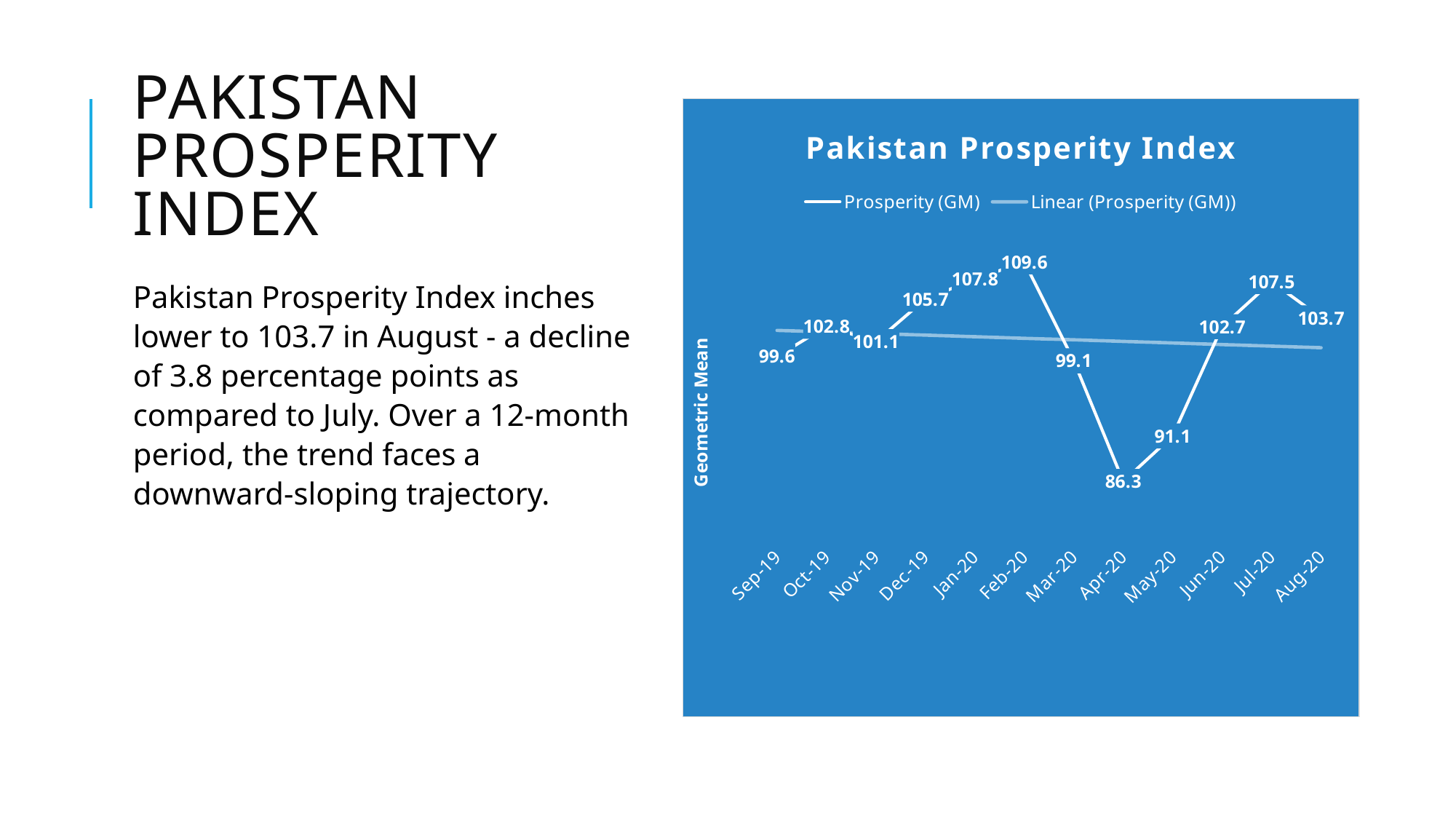
What is the Prosperity (GM) value for Sep-19? 99.6 Which month has the lowest Prosperity (GM) value? Apr-20 What is the label on the vertical axis of the chart? Geometric Mean What is the Prosperity (GM) value for Feb-20? 109.6 Which month has a larger Prosperity (GM) value, Mar-20 or May-20? Mar-20 How many series does the legend list? 2 What kind of chart is shown? Line chart Which month has the highest Prosperity (GM) value? Feb-20 How many months are plotted on the x axis? 12 What is the Prosperity (GM) value for Apr-20? 86.3 Does the Prosperity (GM) value rise or fall from Feb-20 to Apr-20? Fall What is the difference between the Prosperity (GM) values for Jul-20 and Aug-20? 3.8